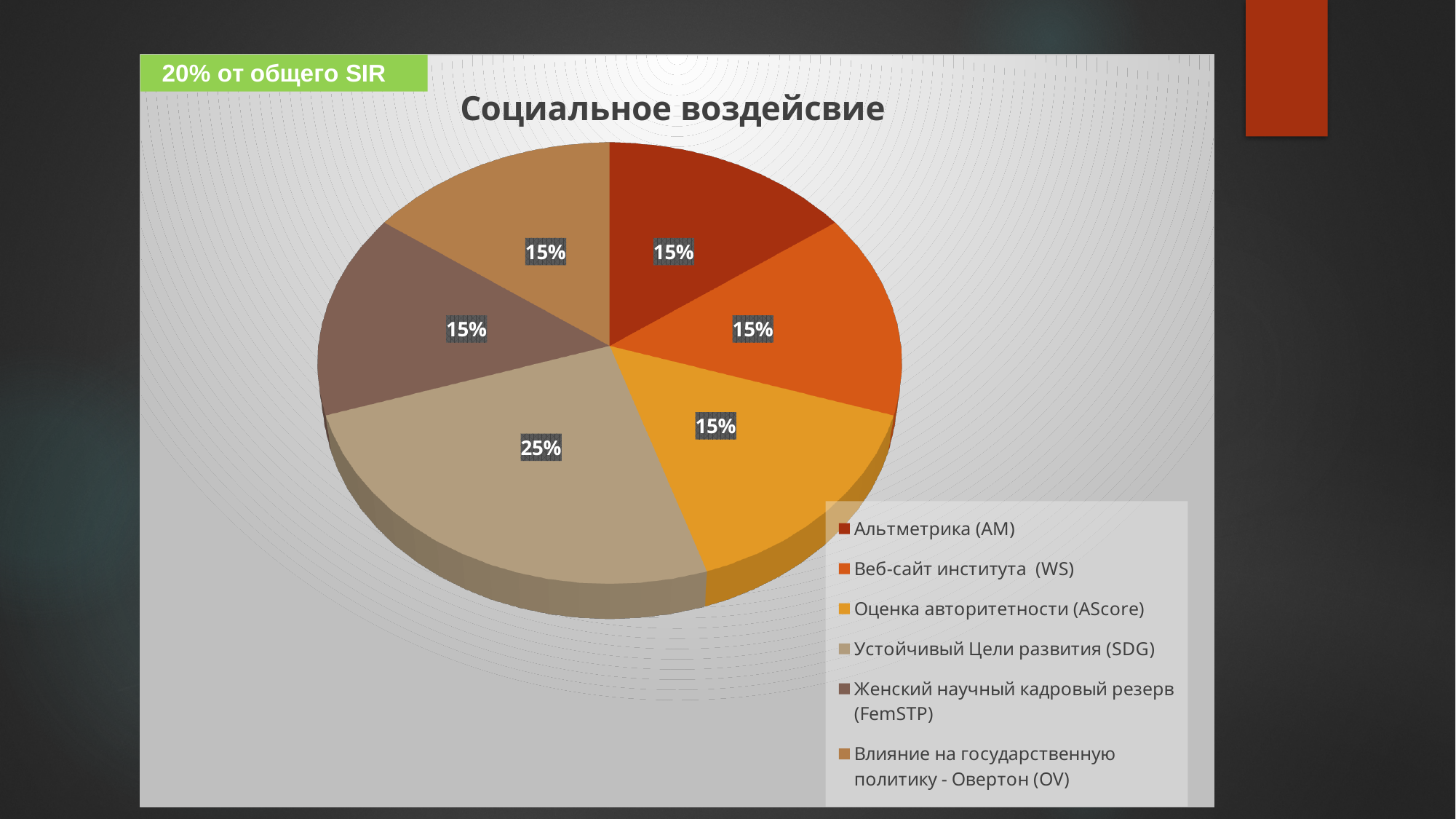
What is the value for Альтметрика (AM)? 15% What share of the pie does Устойчивый Цели развития (SDG) have? 25% Which category has the largest slice of the pie? Устойчивый Цели развития (SDG) What is the value for Веб-сайт института (WS)? 15% What is the difference between the value for Устойчивый Цели развития (SDG) and the value for Альтметрика (AM)? 10% What is the title of the chart? Социальное воздейсвие What is the value for Женский научный кадровый резерв (FemSTP)? 15% What is the value for Влияние на государственную политику - Овертон (OV)? 15% What is the value for Оценка авторитетности (AScore)? 15% Which is larger: the value for Устойчивый Цели развития (SDG) or the value for Веб-сайт института (WS)? Устойчивый Цели развития (SDG) What kind of chart is shown on the slide? pie chart How many slices does the pie chart have? 6